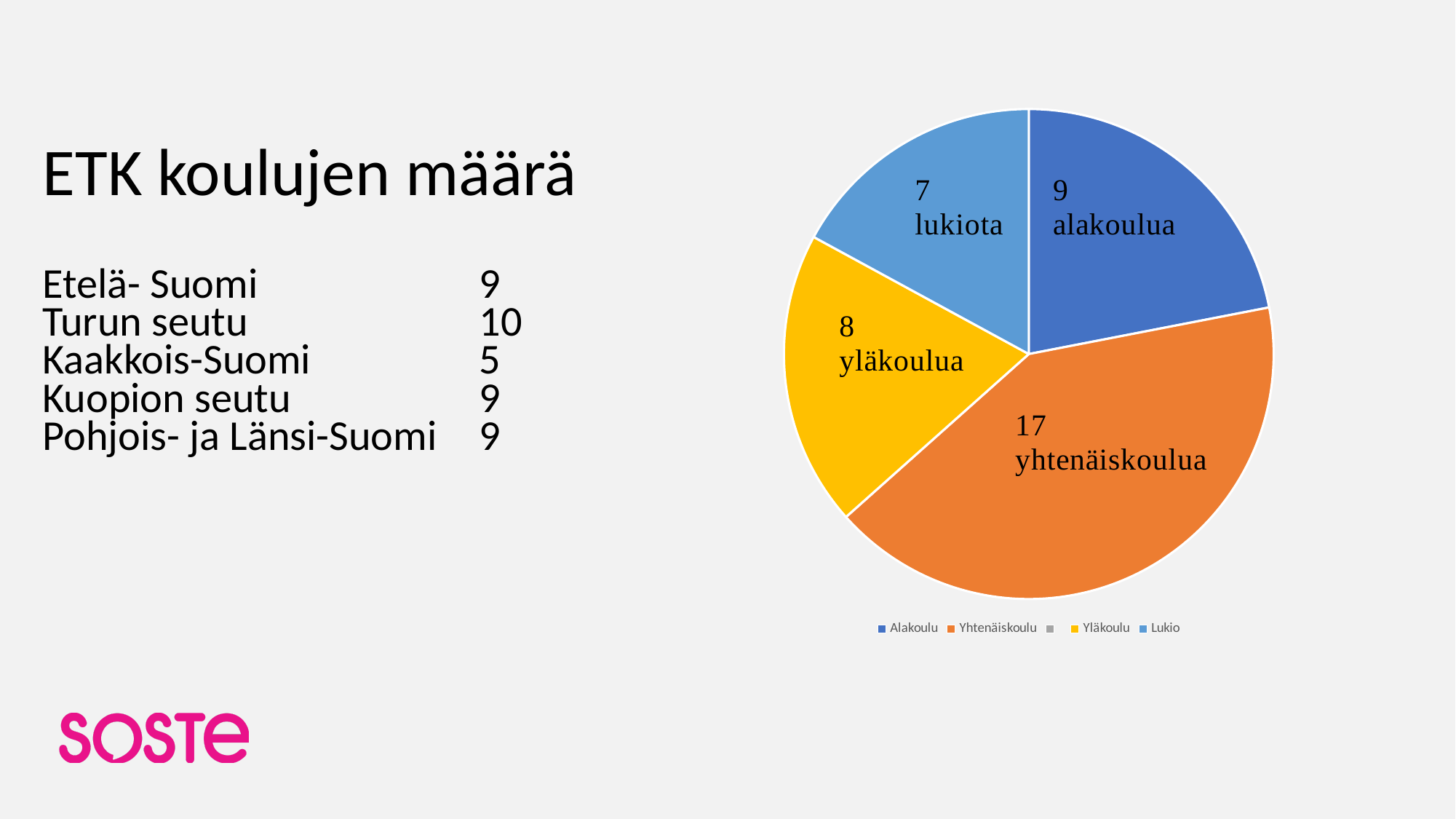
What is the value for yläkoulua in the pie chart? 8 Which slice of the pie chart is the largest? yhtenäiskoulua What is the total of all the values shown in the pie chart? 41 What colour is the yhtenäiskoulua slice in the pie chart? orange What is the value for yhtenäiskoulua in the pie chart? 17 How many slices does the pie chart have? 4 Which is larger in the pie chart, yläkoulua or lukiota? yläkoulua How many alakoulua (primary schools) does the pie chart show? 9 What is the difference between the number of yhtenäiskoulua and the number of alakoulua? 8 Which slice of the pie chart is the smallest? lukiota How many lukiota does the pie chart show? 7 What type of chart is shown on the slide? pie chart